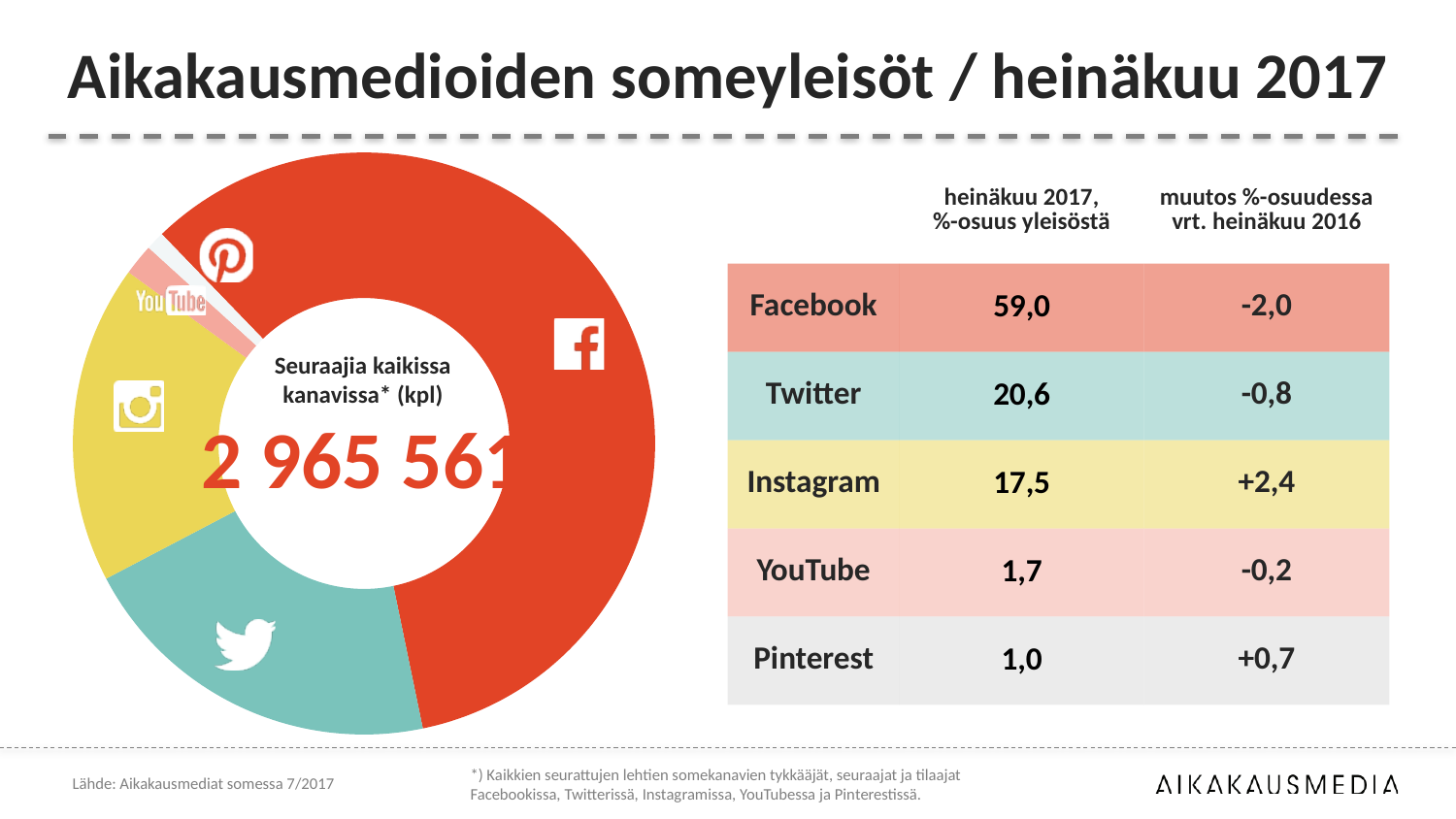
What is Facebook's share of the audience in July 2017 (heinäkuu 2017, %-osuus yleisöstä)? 59,0 How much larger is Facebook's share than Twitter's share in July 2017? 38,4 How many social media channels are shown as slices in the pie chart? 5 What is Instagram's share of the audience in July 2017? 17,5 Which channel has the smallest slice of the pie chart? Pinterest What is the change in percentage share for Facebook compared to July 2016? -2,0 Which channel shows the largest increase in percentage share compared to July 2016? Instagram What colour is the Twitter slice in the pie chart? teal What is the change in percentage share for Instagram compared to July 2016? +2,4 What kind of chart is shown on the left of the slide? pie chart (donut) Which channel has the largest slice of the pie chart? Facebook Which has a larger share of the audience in July 2017, Twitter or Instagram? Twitter